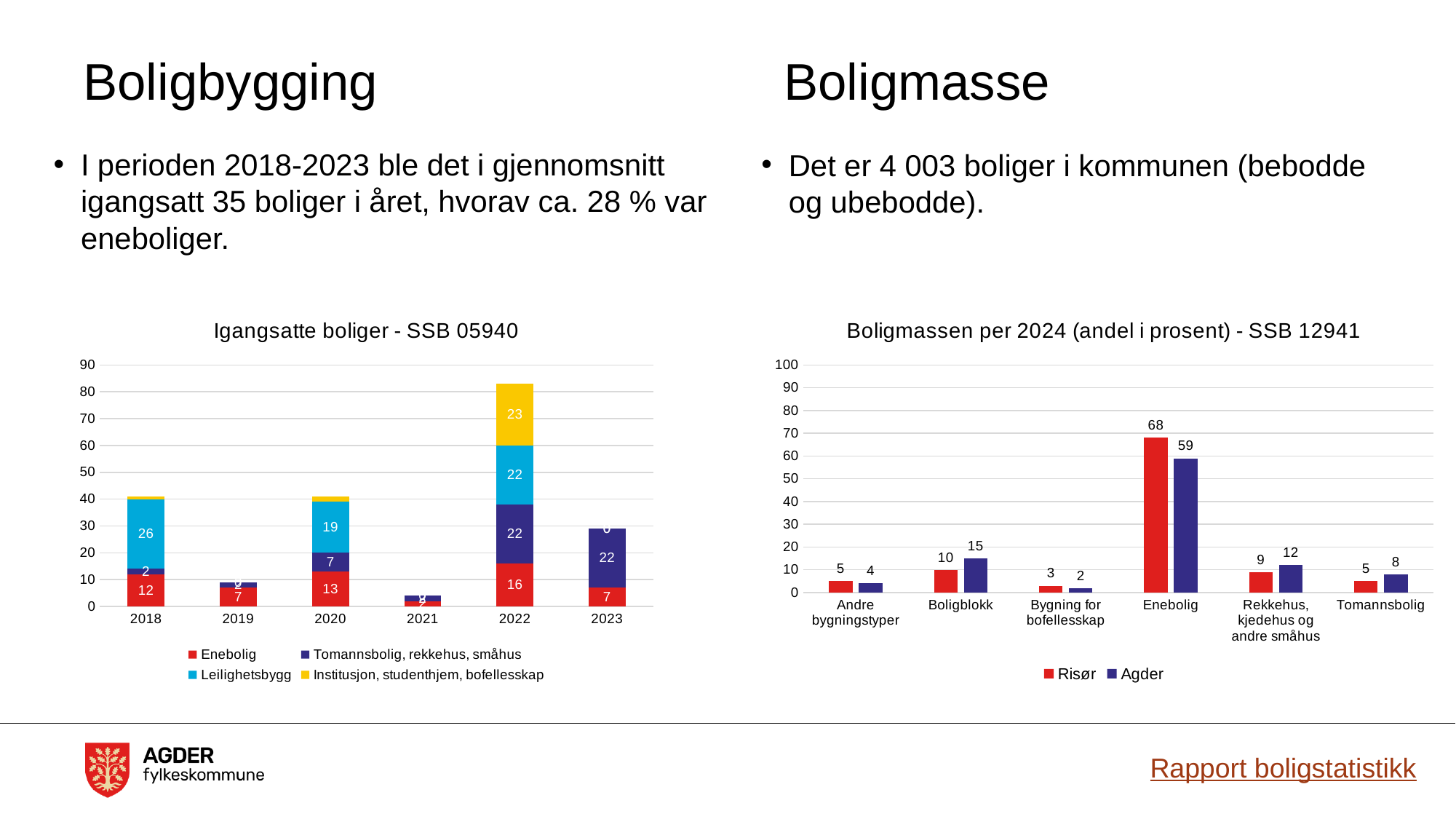
What kind of chart is 'Igangsatte boliger - SSB 05940'? Stacked bar chart In the chart 'Boligmassen per 2024 (andel i prosent) - SSB 12941', what is the value for Agder in the Boligblokk category? 15 In the chart 'Boligmassen per 2024 (andel i prosent) - SSB 12941', what is the value for Risør in the Enebolig category? 68 In the chart 'Boligmassen per 2024 (andel i prosent) - SSB 12941', what is the difference between Risør and Agder for Enebolig? 9 In the chart 'Igangsatte boliger - SSB 05940', what is the value for Leilighetsbygg in 2018? 26 How many series does the legend of the chart 'Igangsatte boliger - SSB 05940' list? 4 In the chart 'Igangsatte boliger - SSB 05940', what is the total of the stacked bar for 2022? 83 How many categories are shown on the x axis of the chart 'Boligmassen per 2024 (andel i prosent) - SSB 12941'? 6 In the chart 'Boligmassen per 2024 (andel i prosent) - SSB 12941', which category has the highest value for Risør? Enebolig In the chart 'Boligmassen per 2024 (andel i prosent) - SSB 12941', which is larger for Rekkehus, kjedehus og andre småhus: Risør or Agder? Agder In the chart 'Boligmassen per 2024 (andel i prosent) - SSB 12941', which category has the lowest value for Agder? Bygning for bofellesskap In the chart 'Igangsatte boliger - SSB 05940', is the total for 2021 greater or less than 10? less